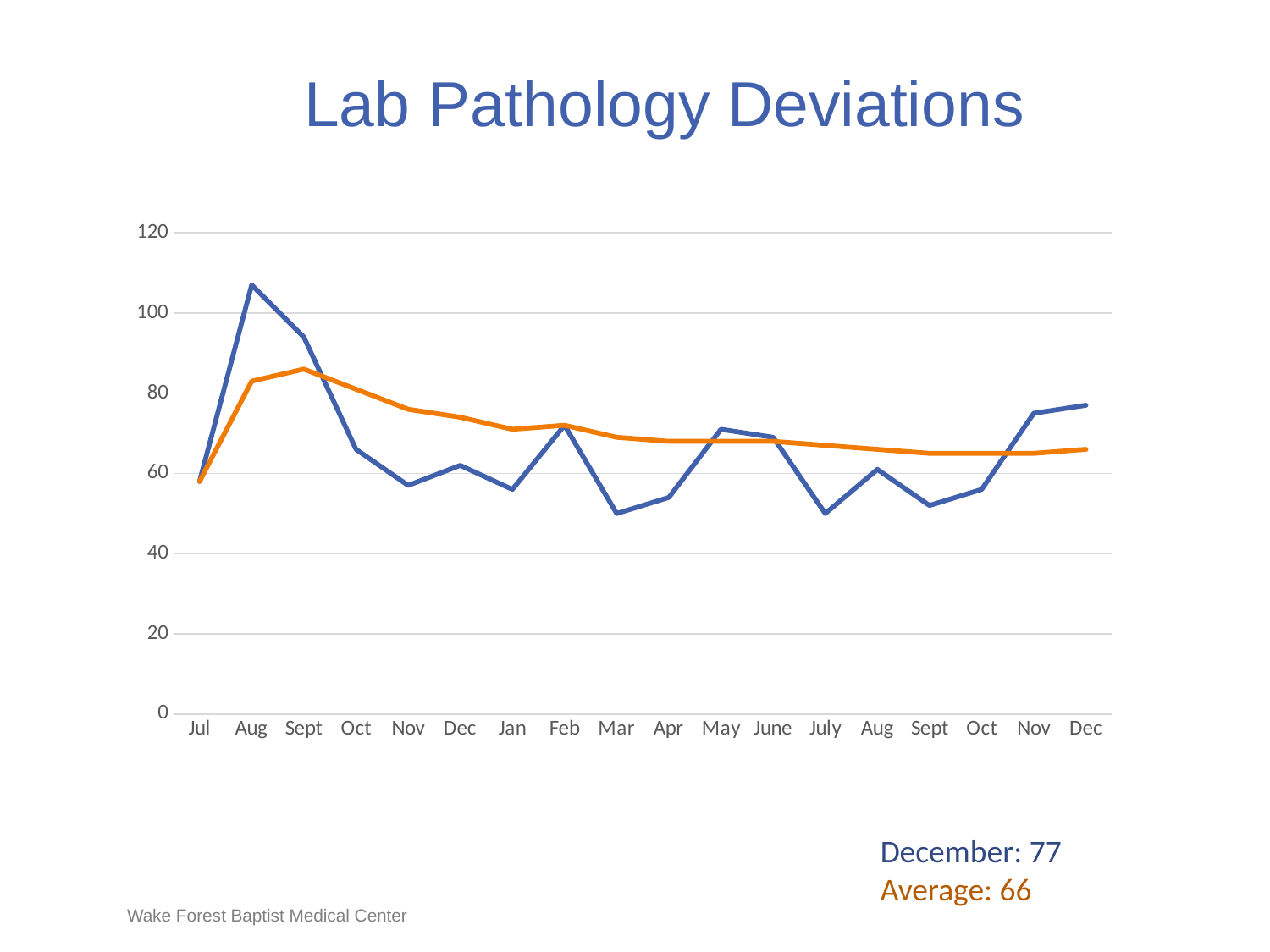
According to the text on the slide, what is the value for December? 77 According to the text on the slide, what is the Average value? 66 What is the title of the chart? Lab Pathology Deviations What kind of chart is shown on the slide? line chart Is the blue line's value for the first Aug greater or less than 100? greater Which is larger on the blue line, the value for Jul or the value for the first Aug? Aug In which month does the blue line reach its highest point? Aug (the first Aug) Is the blue line's value for July (the second year) greater or less than 60? less By how much does the December value (77) exceed the Average (66)? 11 Does the orange line rise or fall from the first Sept to the final Dec? fall Is the blue line's value for Mar greater or less than 60? less How many months are plotted along the x axis? 18